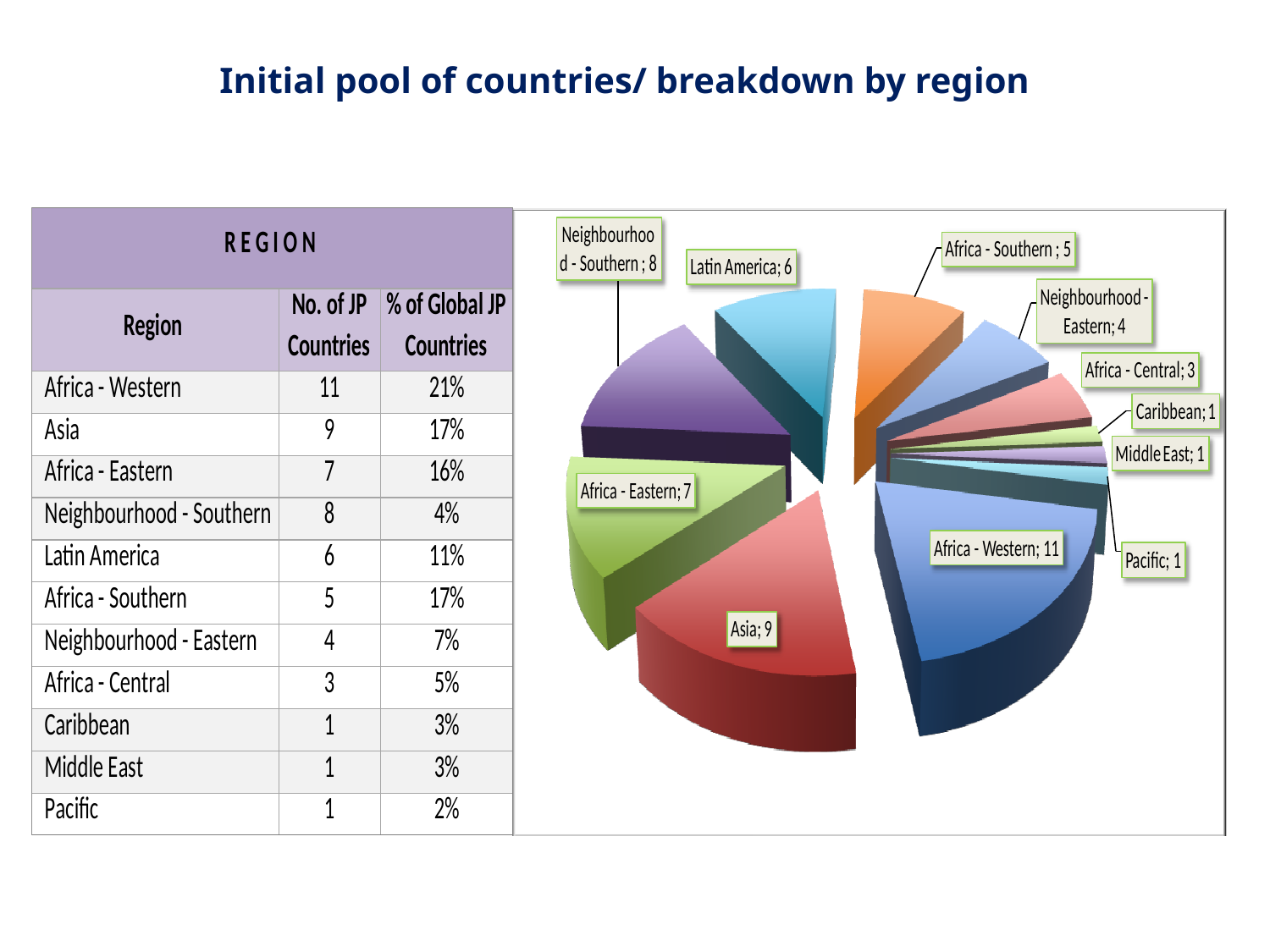
Which regions share the smallest value in the pie chart? Caribbean, Middle East, Pacific How many slices does the pie chart have? 11 What is the value shown for Africa - Central in the pie chart? 3 Which region has the largest slice in the pie chart? Africa - Western What kind of chart is shown on the slide? pie chart What is the value shown for Neighbourhood - Southern in the pie chart? 8 What is the difference between the values for Africa - Western and Asia in the pie chart? 2 Which has a larger value in the pie chart, Latin America or Africa - Southern? Latin America What is the value shown for Africa - Western in the pie chart? 11 What is the difference between the values for Neighbourhood - Southern and Neighbourhood - Eastern in the pie chart? 4 Which has a larger value in the pie chart, Africa - Eastern or Neighbourhood - Southern? Neighbourhood - Southern What is the value shown for Asia in the pie chart? 9